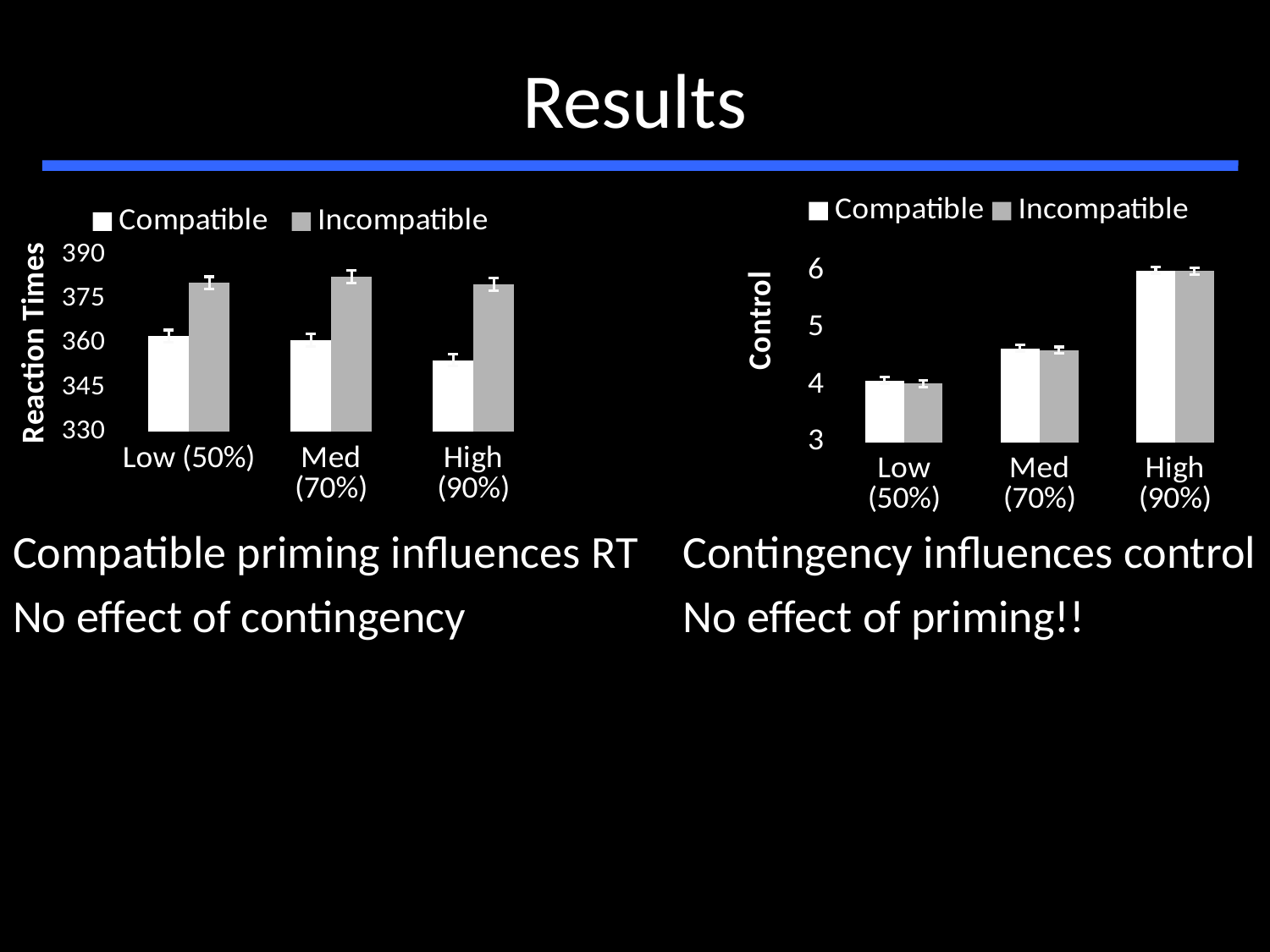
What is the y-axis title of the right chart? Control In the right chart (Control), which category has the highest Compatible value? High (90%) What kind of chart is the left chart (Reaction Times)? bar chart In the right chart (Control), is the Incompatible value for Med (70%) greater or less than 5? less How many categories are shown on the x axis of the right chart (Control)? 3 In the right chart (Control), do the Compatible values rise or fall from Low (50%) to High (90%)? rise In the left chart (Reaction Times), which category has the lowest Compatible value? High (90%) In the right chart (Control), is the Compatible value for High (90%) greater or less than 5? greater In the left chart (Reaction Times), is the Incompatible value for Med (70%) greater or less than 375? greater How many series does the legend of the left chart (Reaction Times) list? 2 In the left chart (Reaction Times), which is larger for Low (50%): the Compatible or the Incompatible value? Incompatible